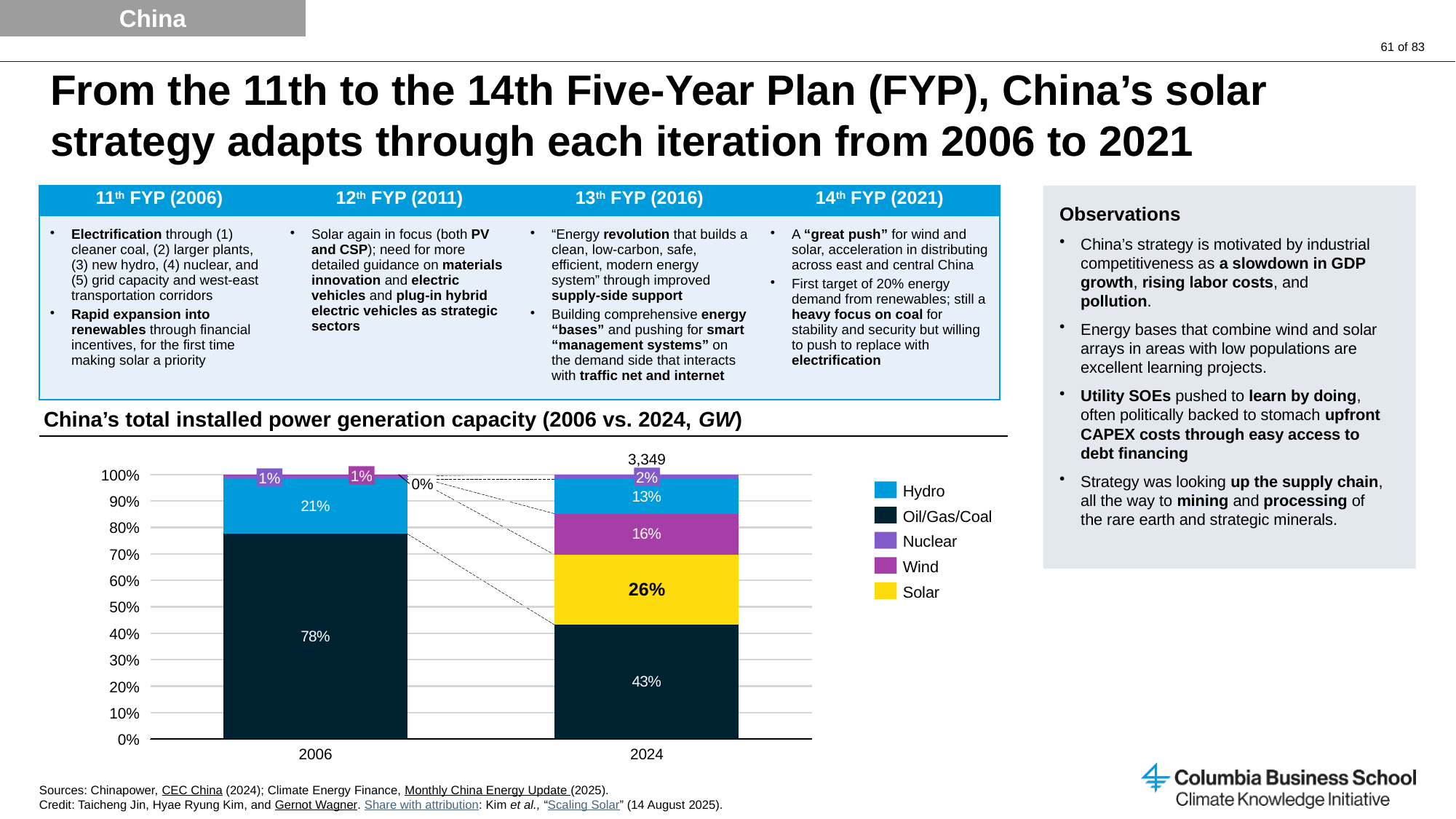
What kind of chart is shown under 'China's total installed power generation capacity'? Stacked bar chart What total installed capacity value (GW) is printed above the 2024 bar? 3,349 What share of China's installed capacity was Hydro in 2006? 21% What share of China's installed capacity was Wind in 2024? 16% By how many percentage points did the Oil/Gas/Coal share fall from 2006 to 2024? 35 percentage points How many years (categories) are shown on the x axis of the capacity chart? 2 What share of China's installed capacity was Oil/Gas/Coal in 2006? 78% How many series does the legend of the capacity chart list? 5 Which source had the largest share of installed capacity in 2024? Oil/Gas/Coal Which is larger in 2024: the Hydro share or the Wind share? Wind What share of China's installed capacity was Solar in 2006? 0% What share of China's installed capacity was Solar in 2024? 26%